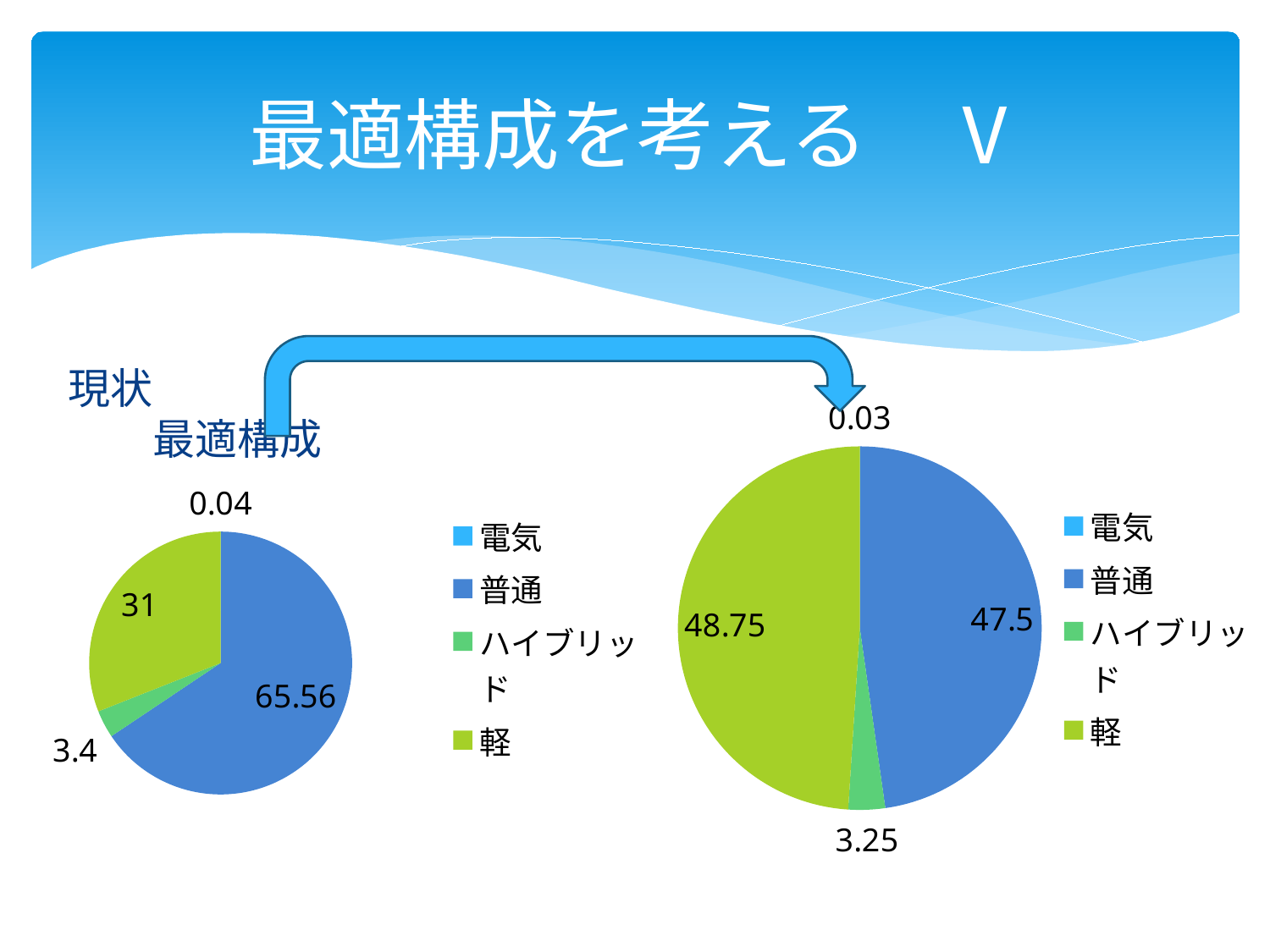
In the left pie chart, what is the value for 普通? 65.56 In the right pie chart, what is the difference between the values for 軽 and 普通? 1.25 In the left pie chart, which is larger, the value for 軽 or the value for ハイブリッド? 軽 How many entries does the legend of the right pie chart list? 4 In the left pie chart, what is the value for ハイブリッド? 3.4 In the right pie chart, what is the value for 電気? 0.03 In the left pie chart, which category has the largest slice? 普通 In the left pie chart, which category has the smallest value? 電気 What kind of chart is the pie on the left side of the slide? pie chart In the left pie chart, what is the value for 軽? 31 In the right pie chart, what is the value for 普通? 47.5 In the right pie chart, what is the value for 軽? 48.75